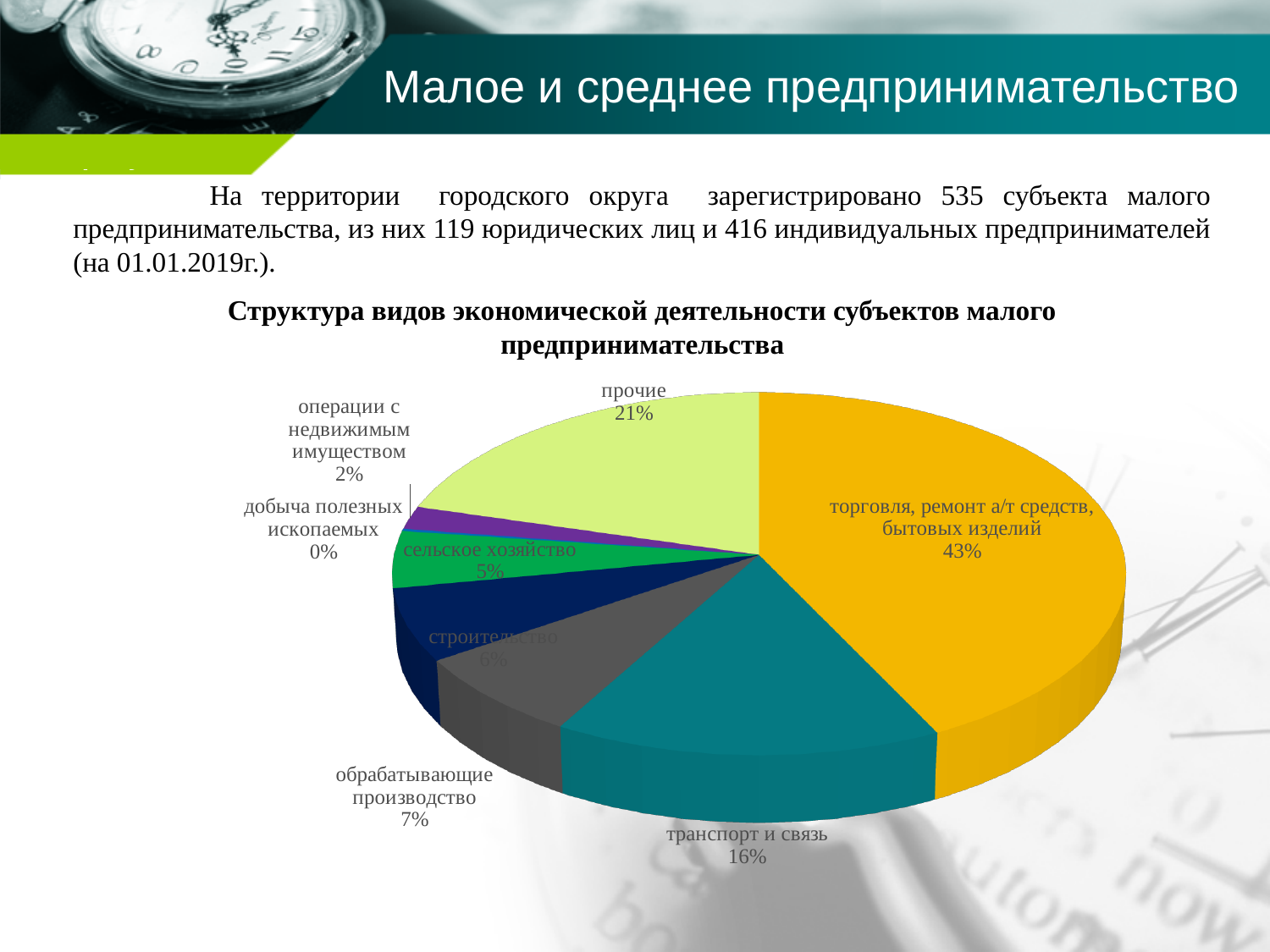
Which is larger, the share for 'строительство' or the share for 'сельское хозяйство'? строительство What is the title of the chart? Структура видов экономической деятельности субъектов малого предпринимательства How many categories are shown in the pie chart? 8 What is the value shown for 'прочие'? 21% Which category has the smallest share of the pie? добыча полезных ископаемых Which category has the largest share of the pie? торговля, ремонт а/т средств, бытовых изделий What type of chart is shown on the slide? pie chart What share of the pie does 'торговля, ремонт а/т средств, бытовых изделий' have? 43% What is the value shown for 'обрабатывающие производство'? 7% What is the value shown for 'транспорт и связь'? 16% What is the difference between the shares of 'прочие' and 'транспорт и связь'? 5% What is the value shown for 'операции с недвижимым имуществом'? 2%